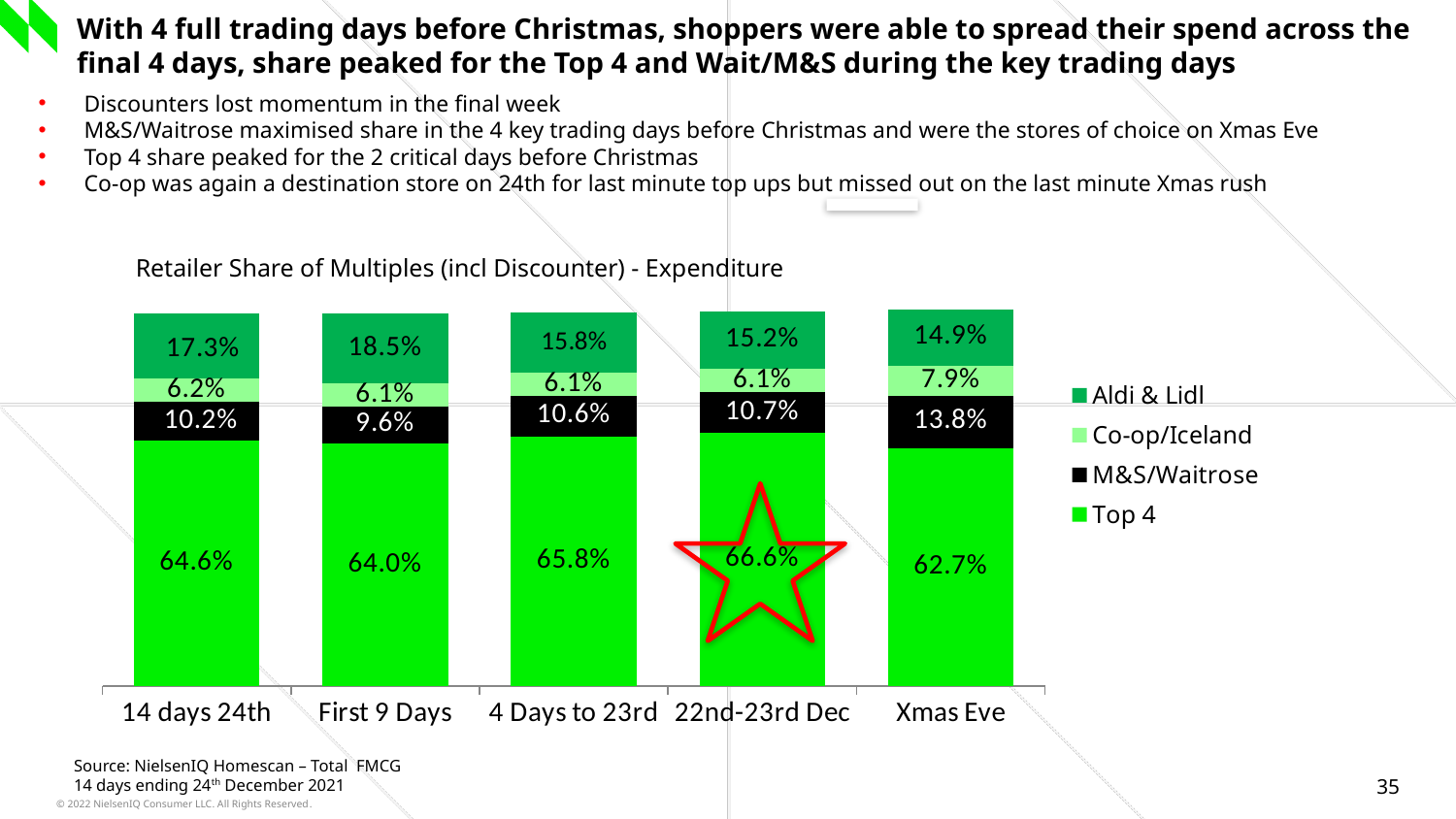
What is the Top 4 share for 22nd-23rd Dec? 66.6% What is the Co-op/Iceland share for 14 days 24th? 6.2% What is the Aldi & Lidl share for First 9 Days? 18.5% Which period has the highest Aldi & Lidl share? First 9 Days Which period has the lowest Top 4 share? Xmas Eve How many periods are shown on the x axis? 5 What is the difference between the Top 4 share for 22nd-23rd Dec and for Xmas Eve? 3.9% Which is larger: the M&S/Waitrose share for 4 Days to 23rd or for First 9 Days? 4 Days to 23rd What is the title of the chart? Retailer Share of Multiples (incl Discounter) - Expenditure What is the M&S/Waitrose share on Xmas Eve? 13.8% What type of chart is shown on the slide? Stacked bar chart How many series does the legend list? 4